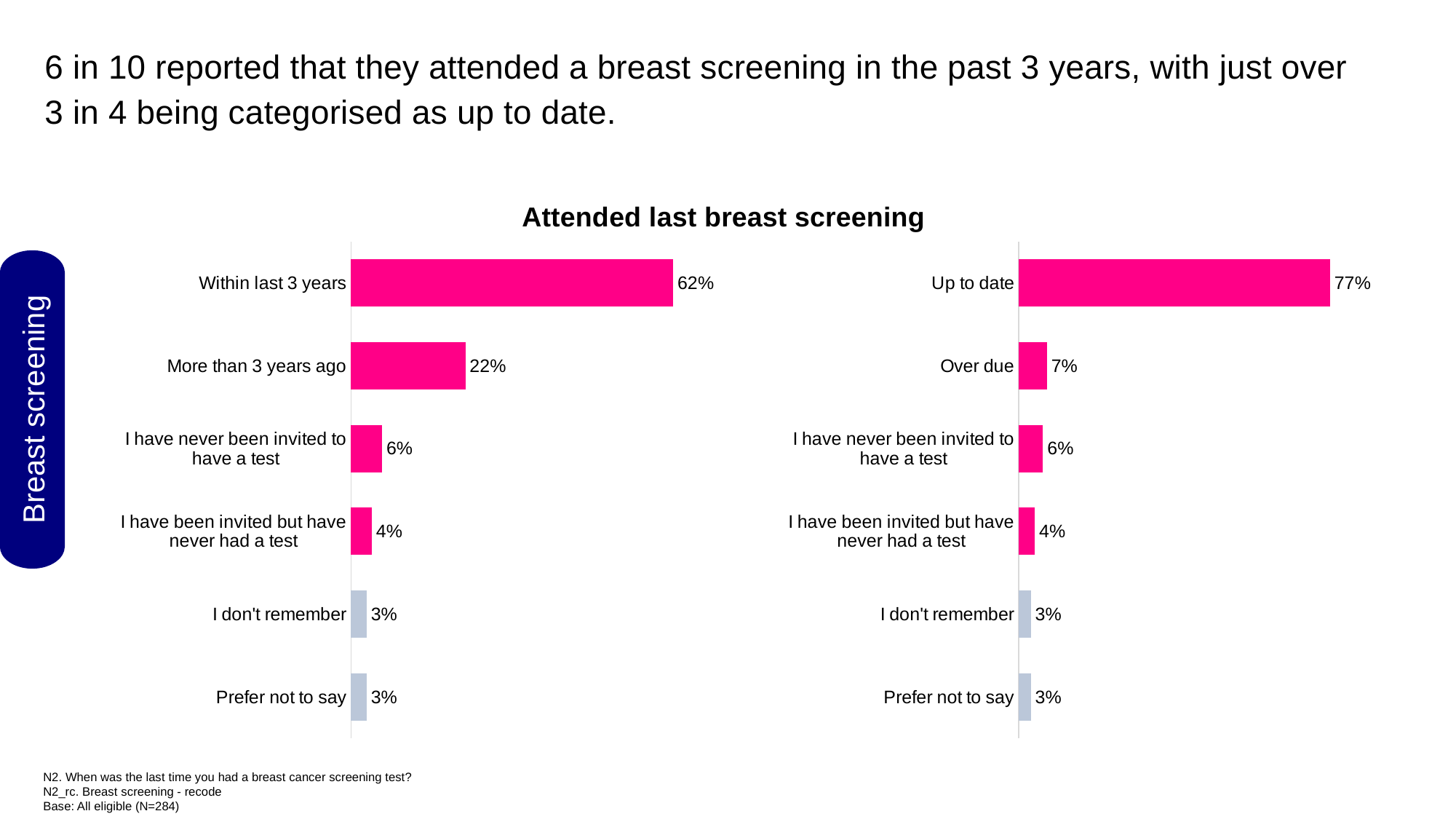
In the right chart, which category has the highest value? Up to date In the left chart, which category has the highest value? Within last 3 years In the left chart, what percentage reported attending a breast screening within the last 3 years? 62% How many categories are shown in the left chart? 6 In the left chart, what is the value for 'More than 3 years ago'? 22% In the left chart, what is the difference between 'Within last 3 years' and 'More than 3 years ago'? 40 percentage points In the left chart, which is larger: 'I have never been invited to have a test' or 'I have been invited but have never had a test'? I have never been invited to have a test What is the title shown above the charts? Attended last breast screening In the right chart, what is the difference between 'Up to date' and 'Over due'? 70 percentage points In the right chart, what percentage are categorised as up to date? 77% What type of chart is used on this slide? Bar chart In the right chart, what is the value for 'Over due'? 7%